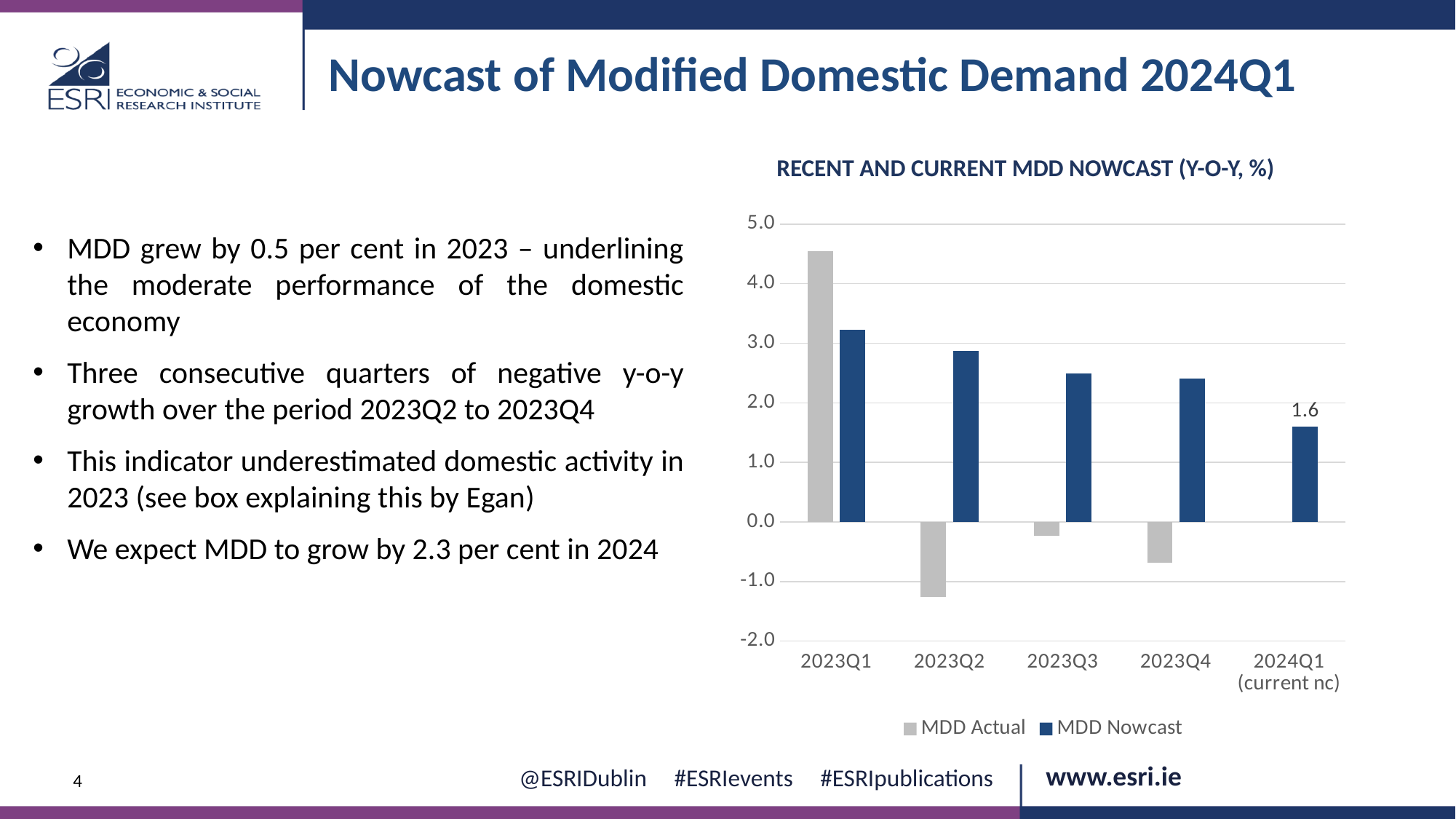
What are the two series named in the legend? MDD Actual and MDD Nowcast How many quarters are shown on the x axis? 5 What is the MDD Nowcast value for 2024Q1 (current nc)? 1.6 Is the MDD Actual value for 2023Q1 greater or less than 4.0? greater Which quarter has the highest MDD Actual value? 2023Q1 How many series does the legend list? 2 Which quarter has the lowest MDD Actual value? 2023Q2 What kind of chart is shown on the slide? Bar chart Which quarter has the highest MDD Nowcast value? 2023Q1 Do the MDD Nowcast values rise or fall from 2023Q1 to 2024Q1? Fall Is the MDD Actual value for 2023Q2 greater or less than -1.0? less For 2023Q1, which is larger: MDD Actual or MDD Nowcast? MDD Actual